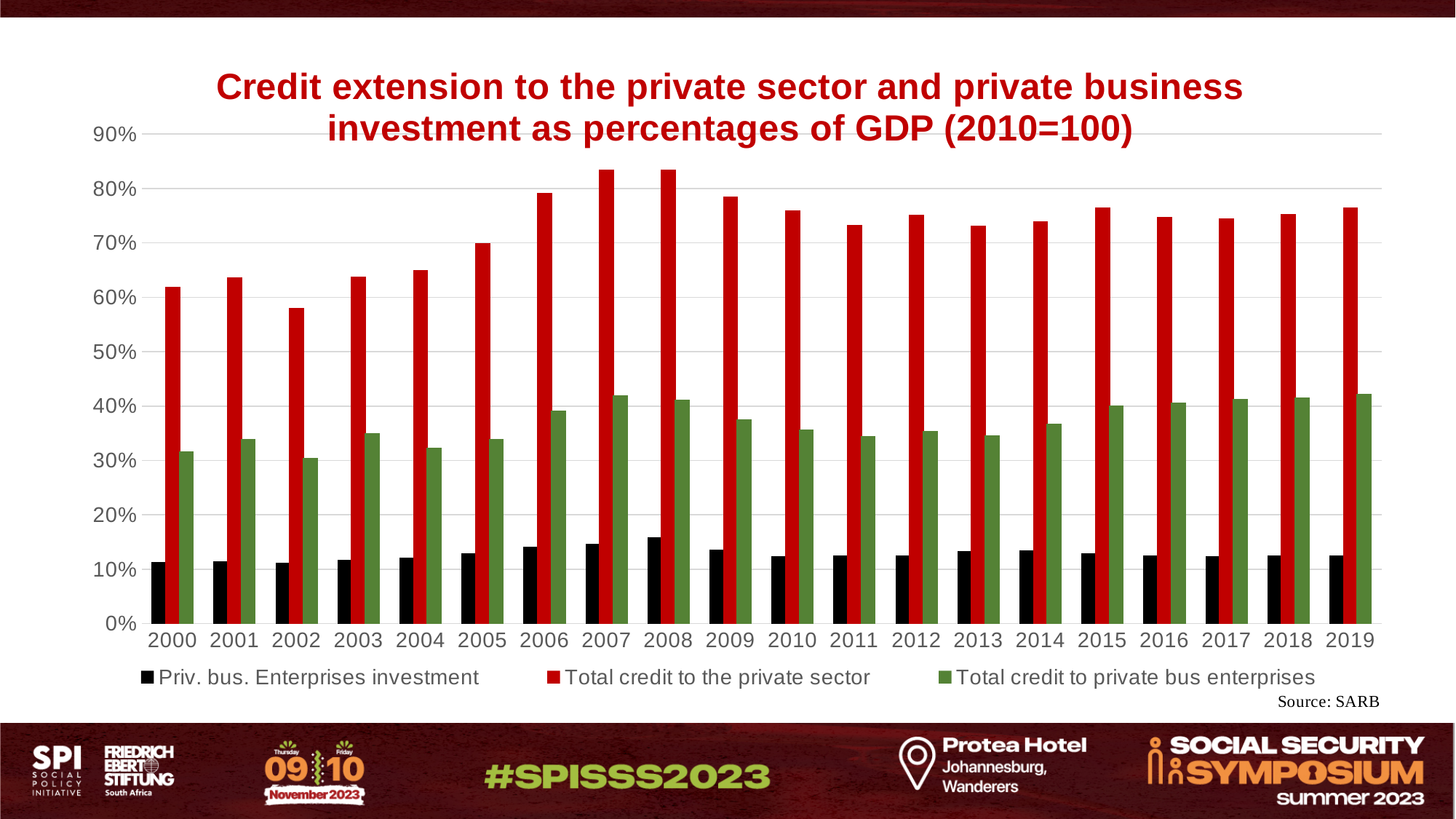
What kind of chart is shown on the slide? Bar chart Does the value for Total credit to the private sector rise or fall from 2002 to 2007? Rise Which colour represents Total credit to the private sector in the legend? Red Is the value for Total credit to private bus enterprises in 2019 greater or less than 40%? greater Is the value for Priv. bus. Enterprises investment in 2000 greater or less than 10%? greater How many series does the legend list? 3 Is the value for Total credit to the private sector in 2002 greater or less than 60%? less Which is larger: Total credit to the private sector in 2006 or in 2000? 2006 In which year is the value for Total credit to the private sector lowest? 2002 How many years are shown on the x axis? 20